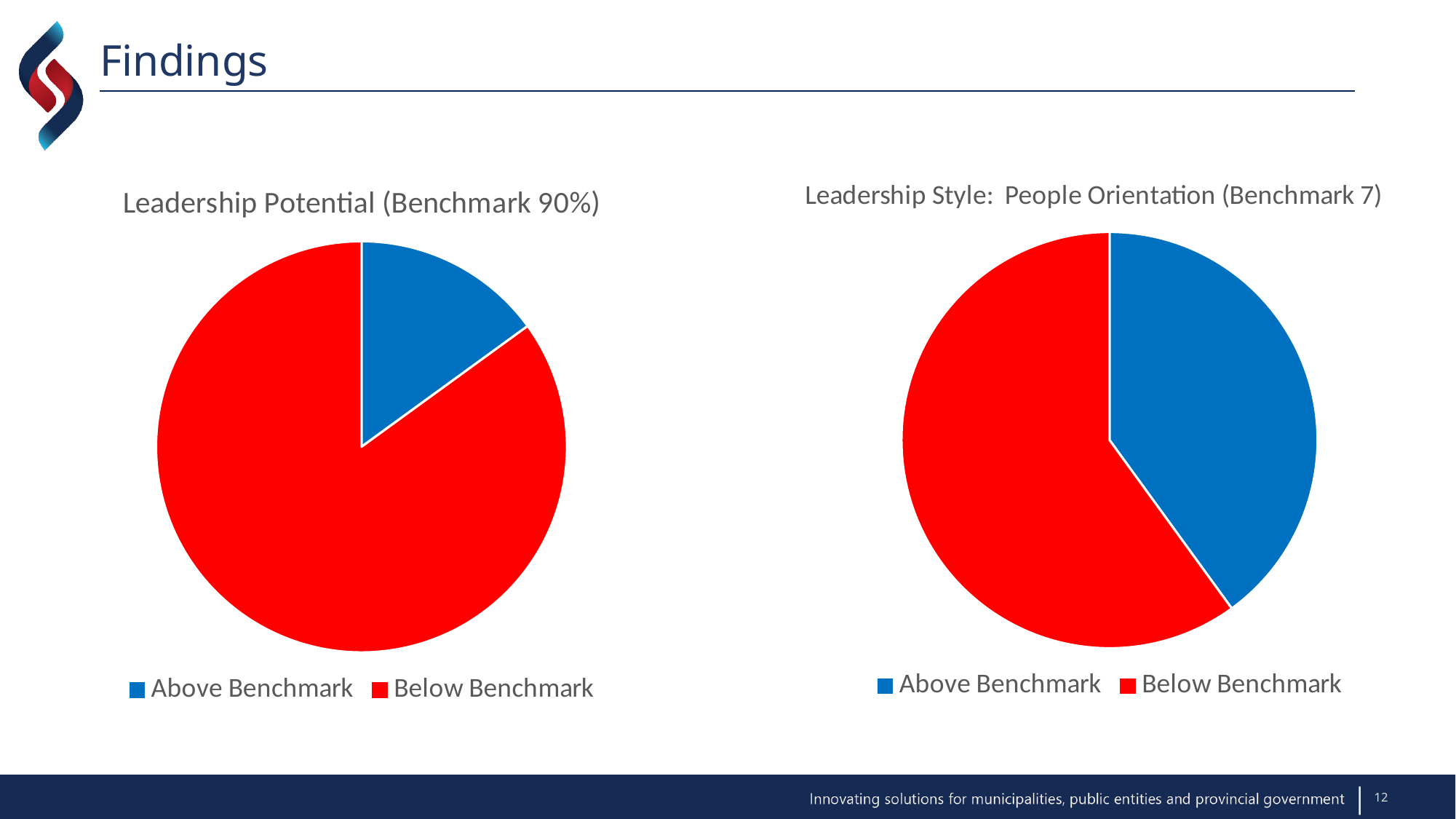
In the "Leadership Potential (Benchmark 90%)" chart, which is larger: Above Benchmark or Below Benchmark? Below Benchmark In the "Leadership Potential (Benchmark 90%)" chart, which category has the smallest slice? Above Benchmark What kind of chart is the "Leadership Potential (Benchmark 90%)" chart? pie chart In the "Leadership Potential (Benchmark 90%)" chart, how many slices does the pie have? 2 In the "Leadership Potential (Benchmark 90%)" chart, which category has the largest slice? Below Benchmark In the "Leadership Style: People Orientation (Benchmark 7)" chart, which category has the largest slice? Below Benchmark In the "Leadership Style: People Orientation (Benchmark 7)" chart, which is larger: Above Benchmark or Below Benchmark? Below Benchmark What colour represents Above Benchmark in the "Leadership Potential (Benchmark 90%)" chart? blue What kind of chart is the "Leadership Style: People Orientation (Benchmark 7)" chart? pie chart What is the title of the pie chart on the right of the slide? Leadership Style: People Orientation (Benchmark 7) In the "Leadership Style: People Orientation (Benchmark 7)" chart, which category has the smallest slice? Above Benchmark In the "Leadership Style: People Orientation (Benchmark 7)" chart, how many categories does the legend list? 2